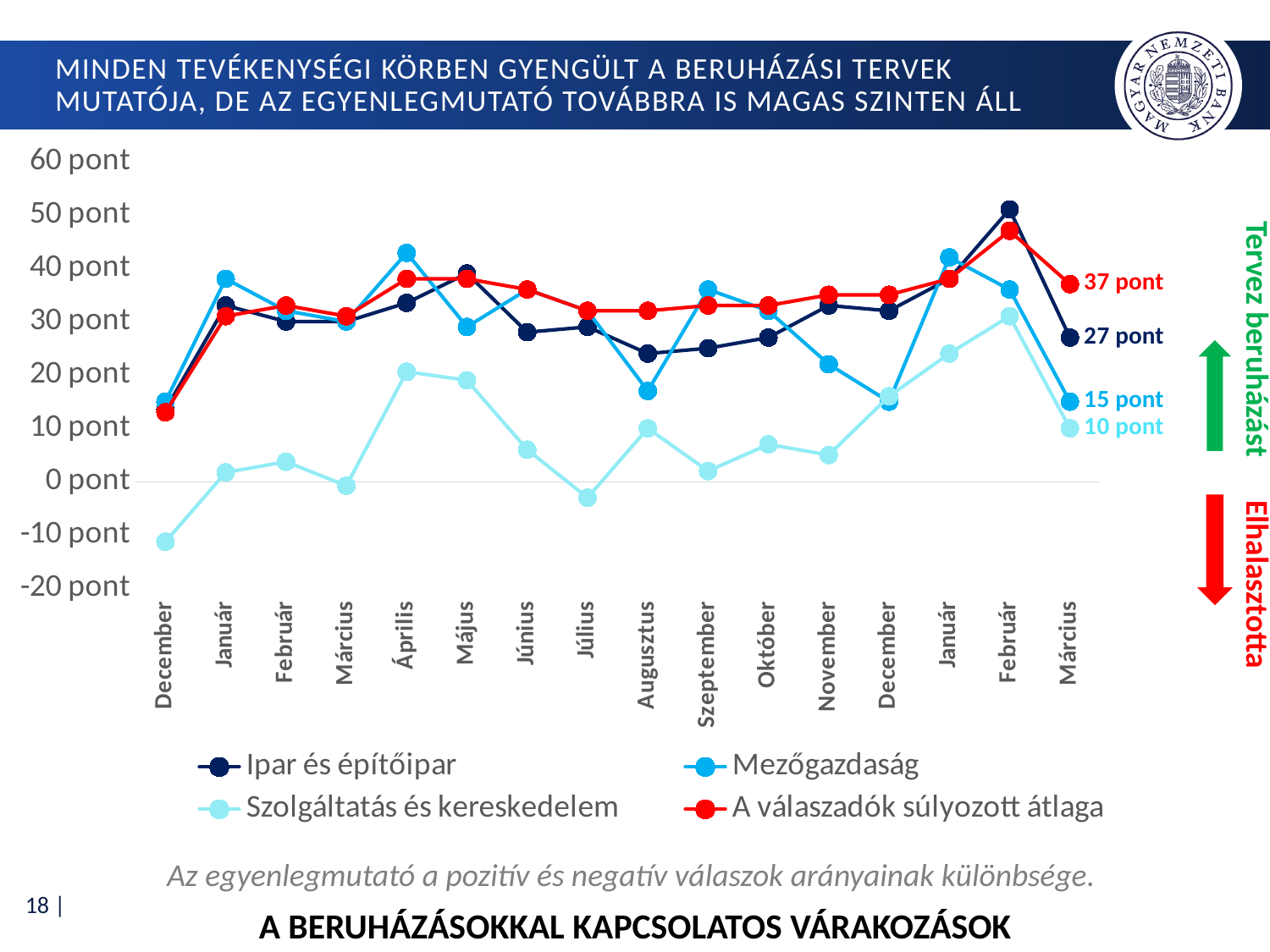
Is the value for Ipar és építőipar at the second Február point greater or less than 40 pont? greater Is the value for Szolgáltatás és kereskedelem at the first December point greater or less than 0 pont? less What is the value for Ipar és építőipar at the final Március point? 27 pont What is the value for Szolgáltatás és kereskedelem at the final Március point? 10 pont At the final Március point, which series has the lowest value? Szolgáltatás és kereskedelem At the final Március point, what is the difference between A válaszadók súlyozott átlaga and Ipar és építőipar? 10 pont What kind of chart is shown on the slide? line chart What is the value for Mezőgazdaság at the final Március point? 15 pont At the final Március point, which is larger: Ipar és építőipar or Mezőgazdaság? Ipar és építőipar How many months are shown on the x axis? 16 How many series does the legend list? 4 What is the value for A válaszadók súlyozott átlaga at the final Március point? 37 pont